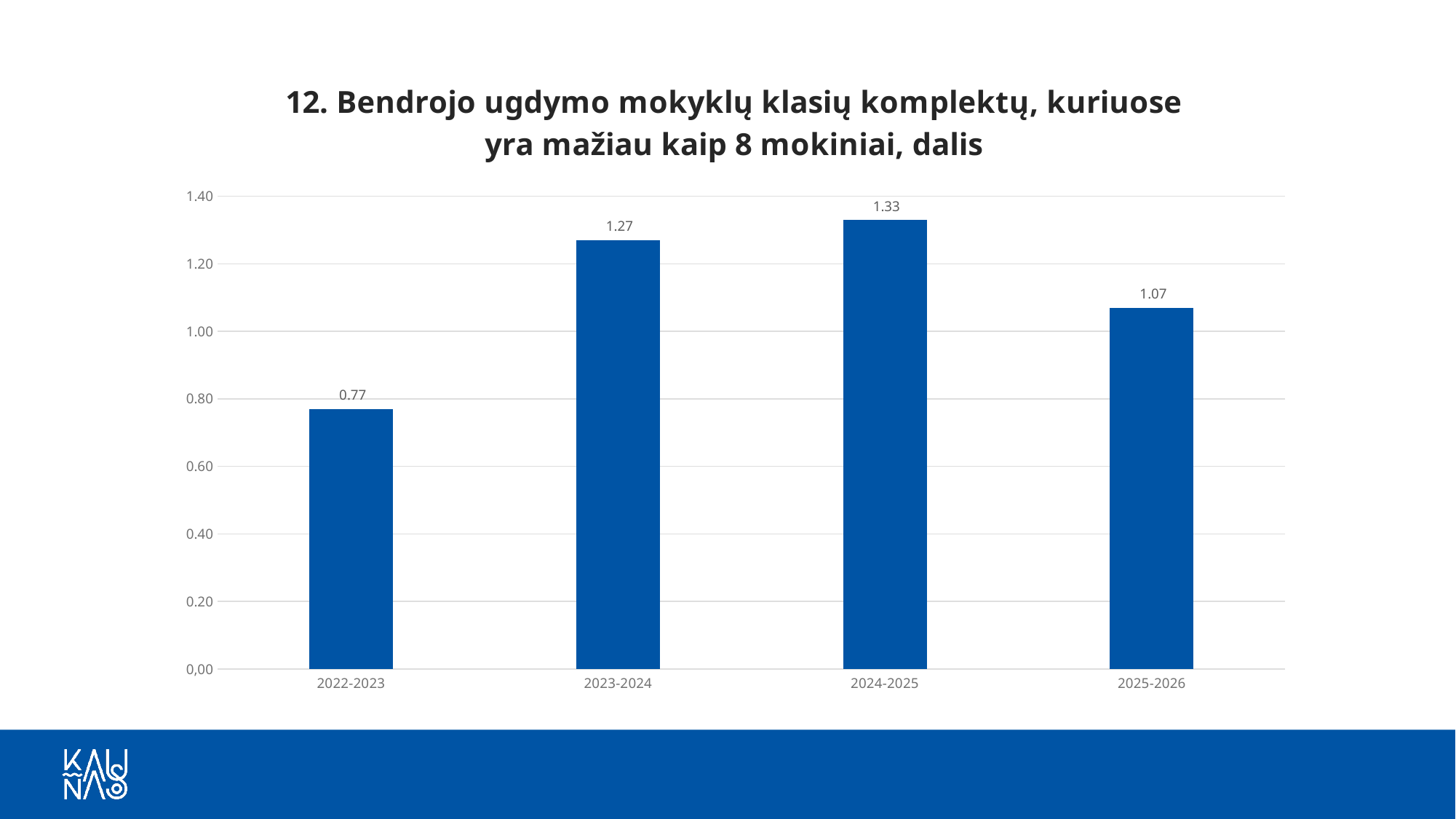
What is the value for 2022-2023? 0.77 What is the difference between the values for 2024-2025 and 2022-2023? 0.56 What is the value for 2025-2026? 1.07 What is the value for 2023-2024? 1.27 How many school years are shown on the x axis? 4 Which school year has the lowest value? 2022-2023 What kind of chart is shown on the slide? Bar chart Which is larger, the value for 2023-2024 or the value for 2025-2026? 2023-2024 What is the value for 2024-2025? 1.33 What is the difference between the values for 2023-2024 and 2025-2026? 0.20 Which school year has the highest value? 2024-2025 Does the value rise or fall from 2024-2025 to 2025-2026? Fall